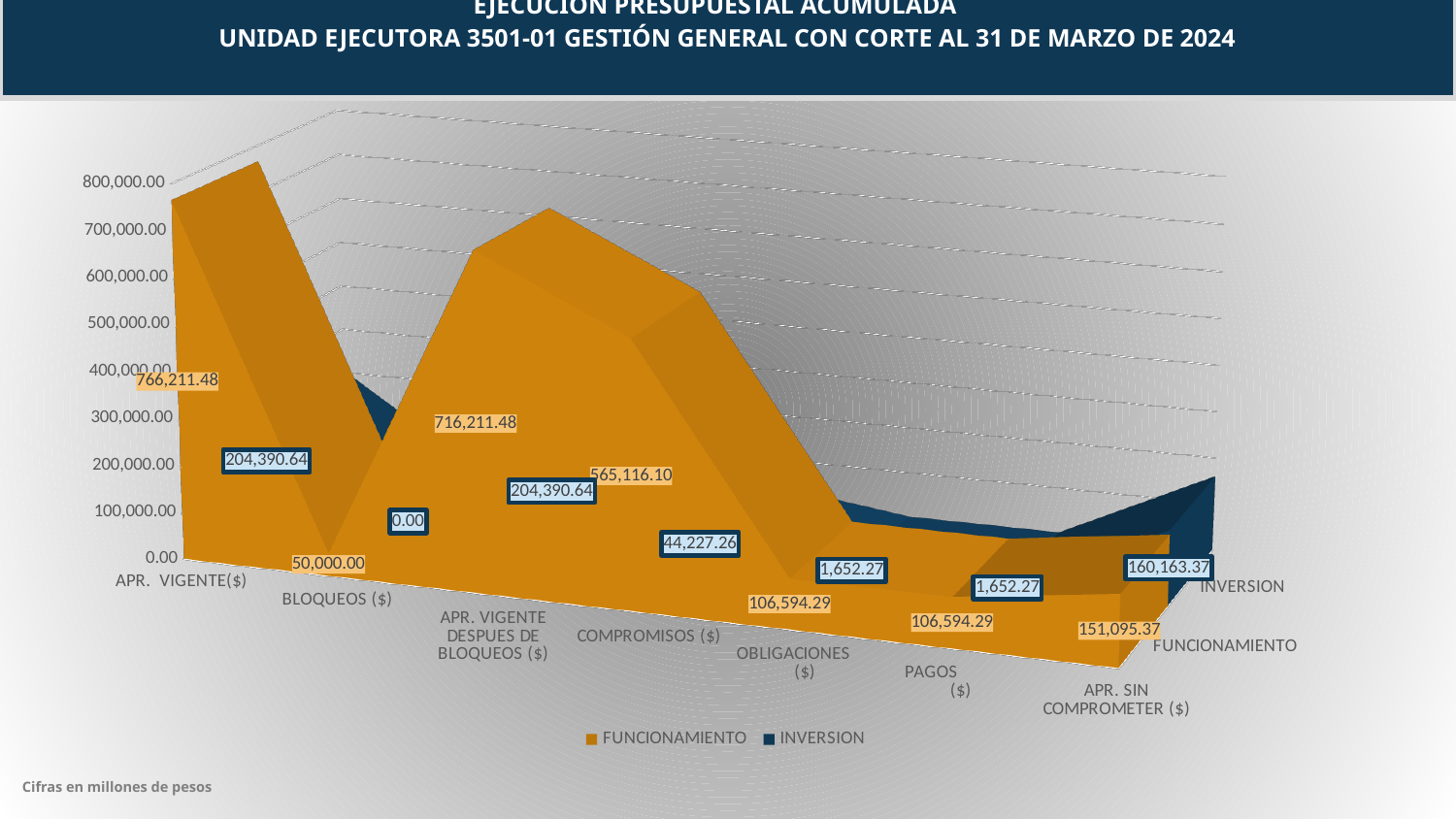
What is the INVERSION value for BLOQUEOS ($)? 0.00 What is the FUNCIONAMIENTO value for COMPROMISOS ($)? 565,116.10 How many categories are shown on the x axis? 7 Which category has the lowest INVERSION value? BLOQUEOS ($) Which category has the highest FUNCIONAMIENTO value? APR. VIGENTE($) What is the difference between the FUNCIONAMIENTO values for APR. VIGENTE($) and APR. VIGENTE DESPUES DE BLOQUEOS ($)? 50,000.00 What kind of chart is shown on the slide? Area chart What is the INVERSION value for APR. SIN COMPROMETER ($)? 160,163.37 What is the INVERSION value for OBLIGACIONES ($)? 1,652.27 Which is larger for APR. SIN COMPROMETER ($): FUNCIONAMIENTO or INVERSION? INVERSION What is the FUNCIONAMIENTO value for APR. VIGENTE($)? 766,211.48 How many series does the legend list? 2